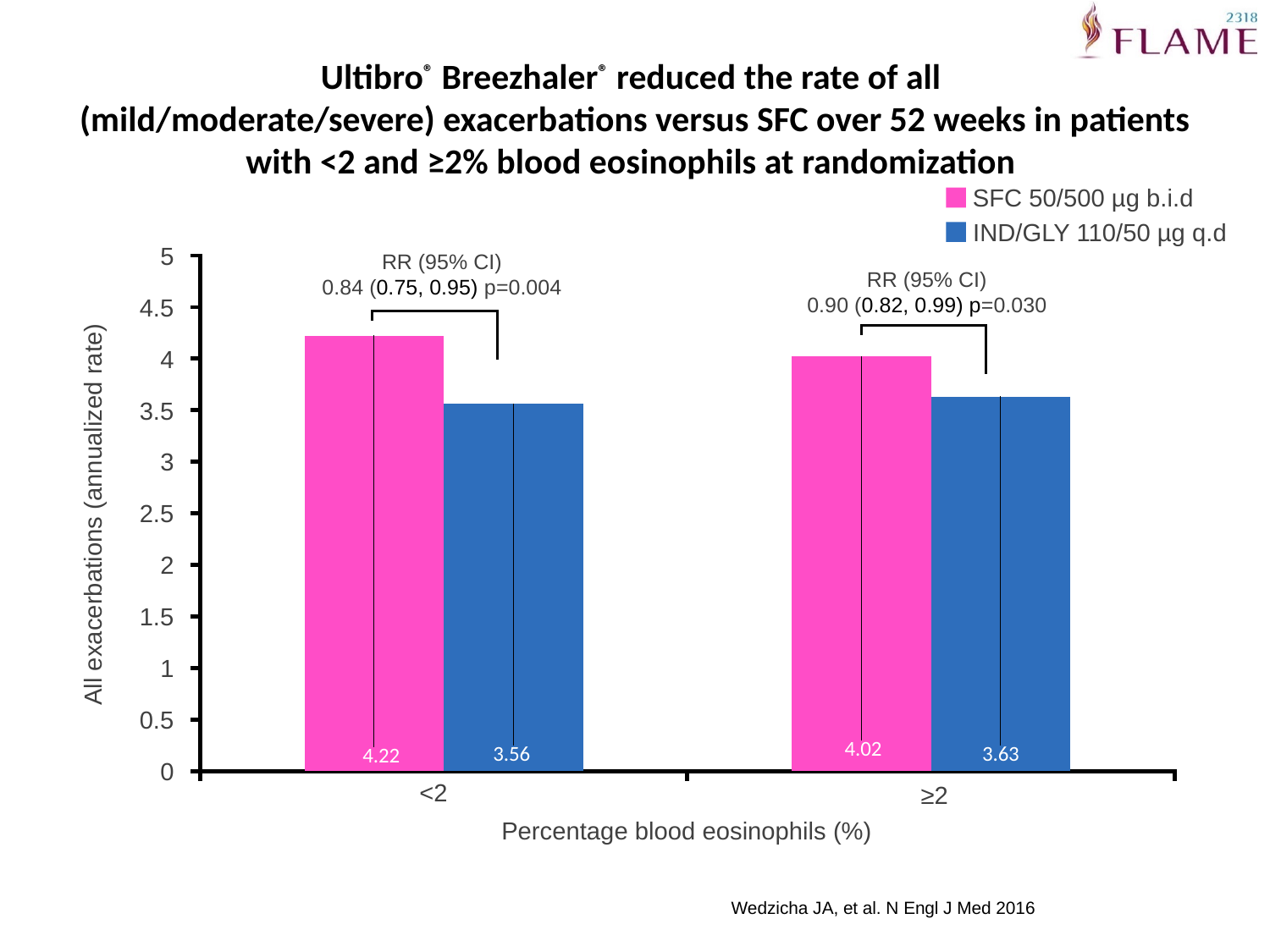
What is the rate ratio (RR) with 95% CI shown for the <2% blood eosinophils group? 0.84 (0.75, 0.95) p=0.004 What is the annualized rate of all exacerbations for IND/GLY 110/50 µg q.d in the <2% blood eosinophils group? 3.56 What is the difference between the SFC and IND/GLY exacerbation rates in the <2% blood eosinophils group? 0.66 What is the annualized rate of all exacerbations for IND/GLY 110/50 µg q.d in the ≥2% blood eosinophils group? 3.63 Which bar has the lowest annualized exacerbation rate on the chart? IND/GLY 110/50 µg q.d in the <2 group (3.56) Which bar has the highest annualized exacerbation rate on the chart? SFC 50/500 µg b.i.d in the <2 group (4.22) What is the difference between the SFC and IND/GLY exacerbation rates in the ≥2% blood eosinophils group? 0.39 What is the annualized rate of all exacerbations for SFC 50/500 µg b.i.d in the <2% blood eosinophils group? 4.22 In the ≥2% blood eosinophils group, which treatment has the higher annualized exacerbation rate? SFC 50/500 µg b.i.d What kind of chart is shown on the slide? Bar chart How many series does the legend list? 2 What is the annualized rate of all exacerbations for SFC 50/500 µg b.i.d in the ≥2% blood eosinophils group? 4.02